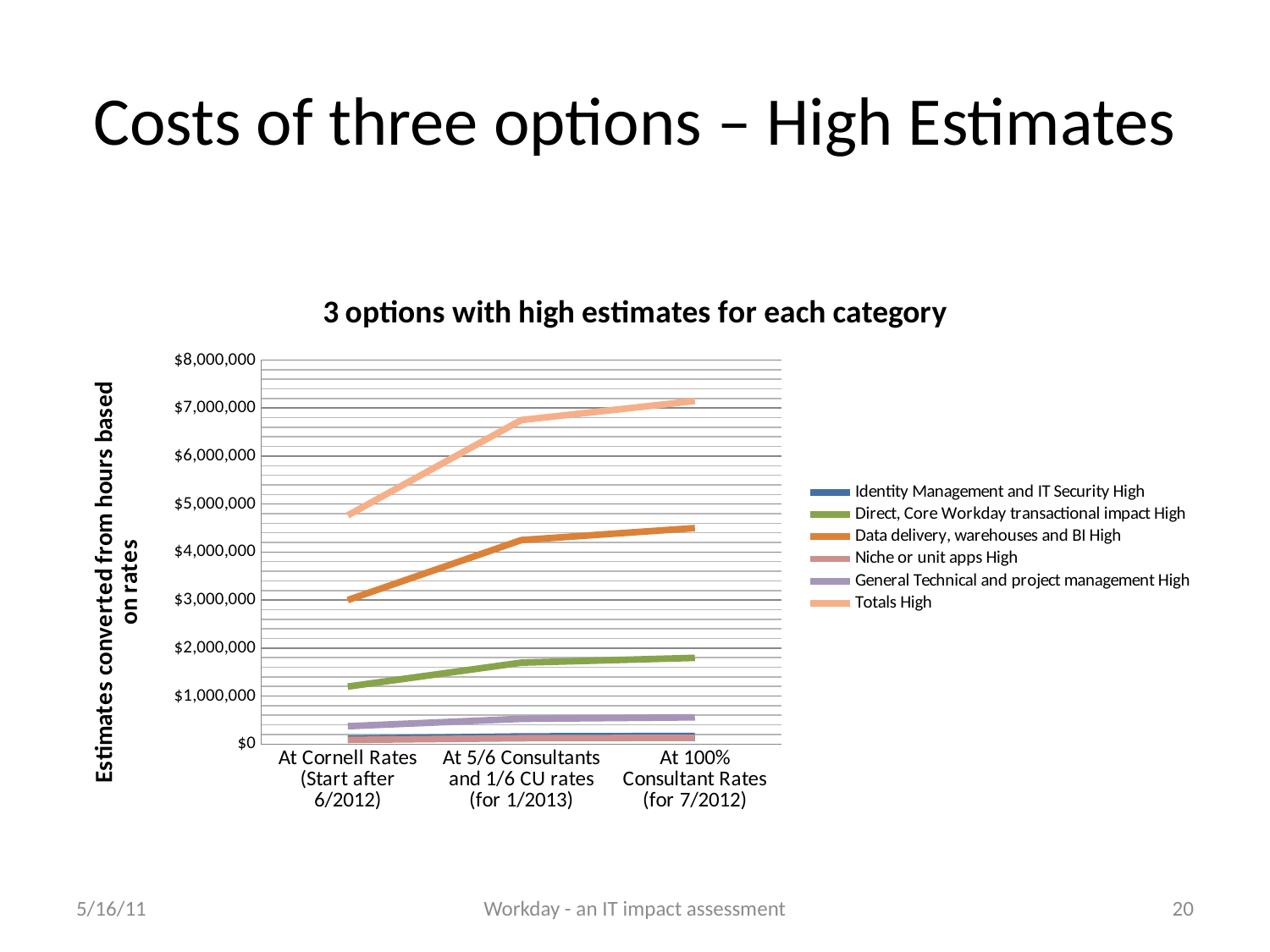
Does the Totals High series rise or fall from 'At Cornell Rates' to 'At 100% Consultant Rates'? rise At 100% Consultant Rates, which is larger: Data delivery, warehouses and BI High or Direct, Core Workday transactional impact High? Data delivery, warehouses and BI High Which series has the highest values across all three options? Totals High Is the value for Data delivery, warehouses and BI High at 100% Consultant Rates greater or less than $4,000,000? greater What is the title of the chart? 3 options with high estimates for each category How many options (categories) are plotted along the x axis? 3 What kind of chart is shown on the slide? line chart Is the value for Totals High at Cornell Rates greater or less than $4,000,000? greater Is the value for Direct, Core Workday transactional impact High at 100% Consultant Rates greater or less than $2,000,000? less What is the label on the vertical axis of the chart? Estimates converted from hours based on rates How many series does the legend list? 6